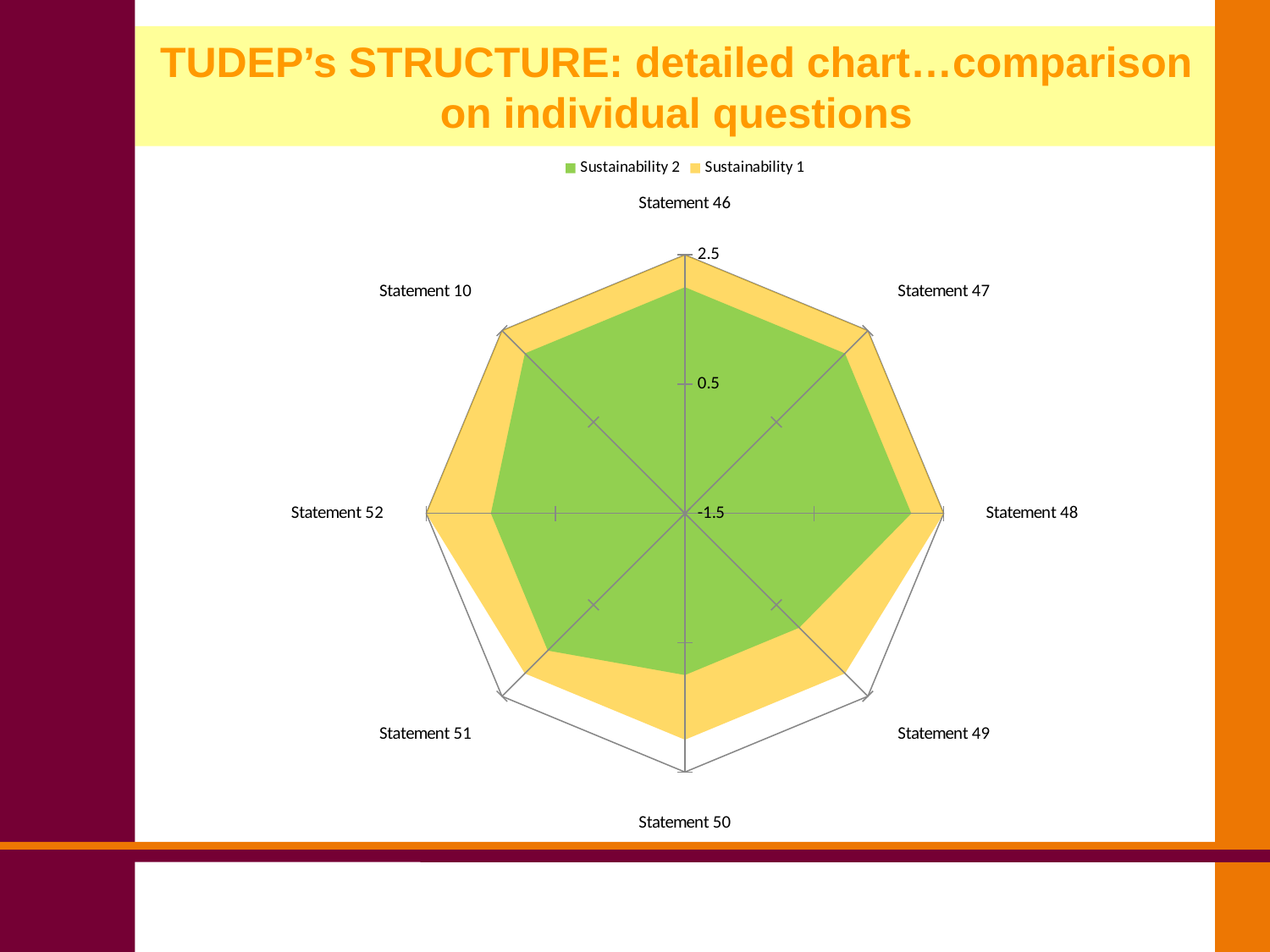
Is the Sustainability 1 value for Statement 52 greater or less than 0.5? greater What is the highest value shown on the radar chart's axis scale? 2.5 How many statements (categories) are plotted on the radar chart? 8 For Statement 46, which series has the larger value, Sustainability 1 or Sustainability 2? Sustainability 1 What kind of chart is shown on the slide? radar chart Is the Sustainability 1 value for Statement 48 greater or less than 0.5? greater How many series does the legend list? 2 Which series is drawn in green? Sustainability 2 Which series is drawn in yellow? Sustainability 1 Is the Sustainability 2 value for Statement 46 greater or less than 0.5? greater For Statement 48, which series has the larger value, Sustainability 1 or Sustainability 2? Sustainability 1